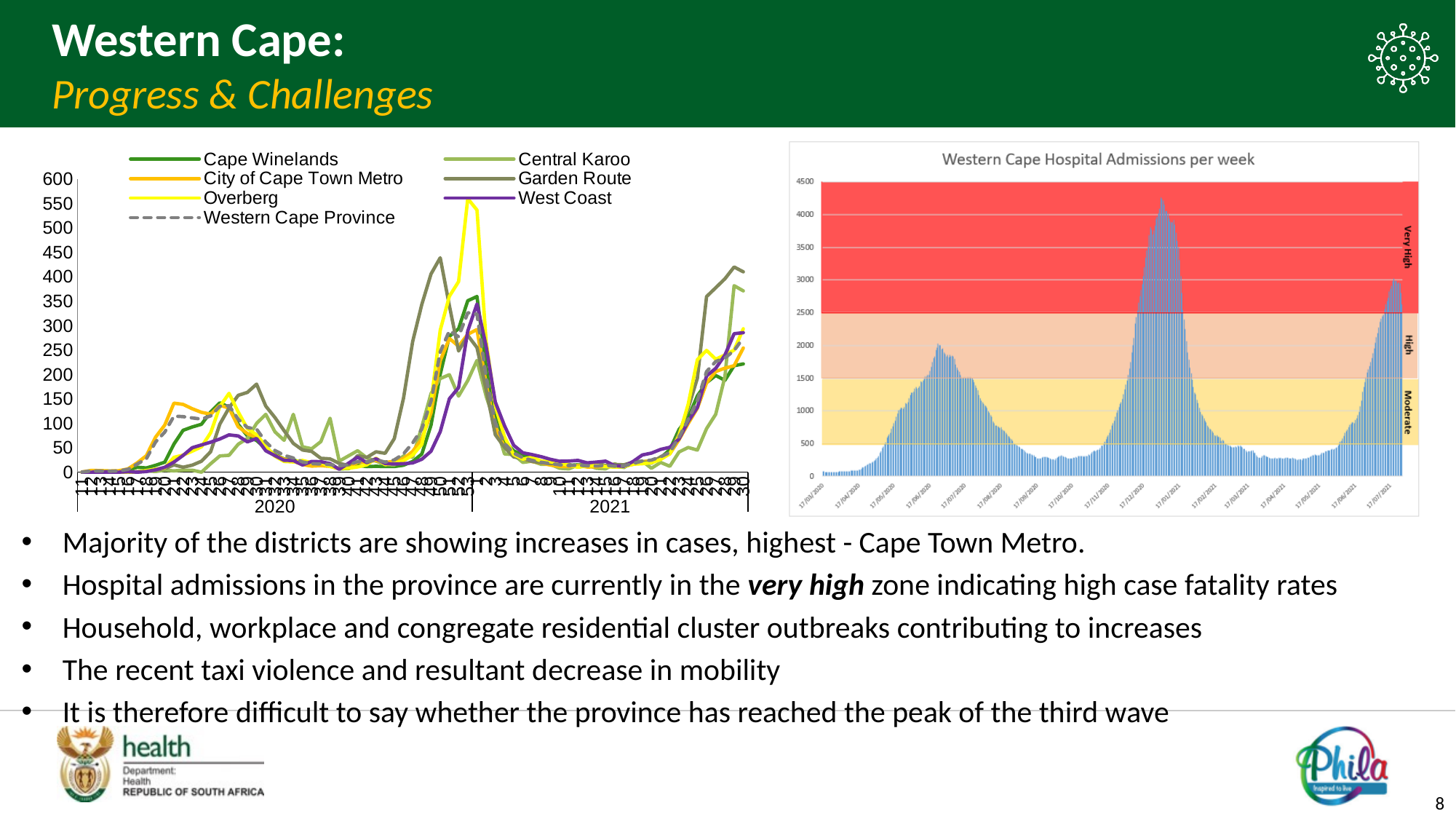
How many series does the legend of the left chart list? 7 What is the highest tick shown on the y axis of the left chart? 600 In the left chart, is the 2020 peak value for Garden Route greater or less than 400? greater In the left chart, which series reaches the highest peak? Overberg In the left chart, is the peak value for Overberg greater or less than 500? greater What is the title of the chart on the right of the slide? Western Cape Hospital Admissions per week What kind of chart is the chart on the left of the slide? line chart What kind of chart is the 'Western Cape Hospital Admissions per week' chart? bar chart In the left chart, which series is drawn with a dashed line? Western Cape Province In the 'Western Cape Hospital Admissions per week' chart, is the peak of the first wave (mid-2020) greater or less than 2500? less